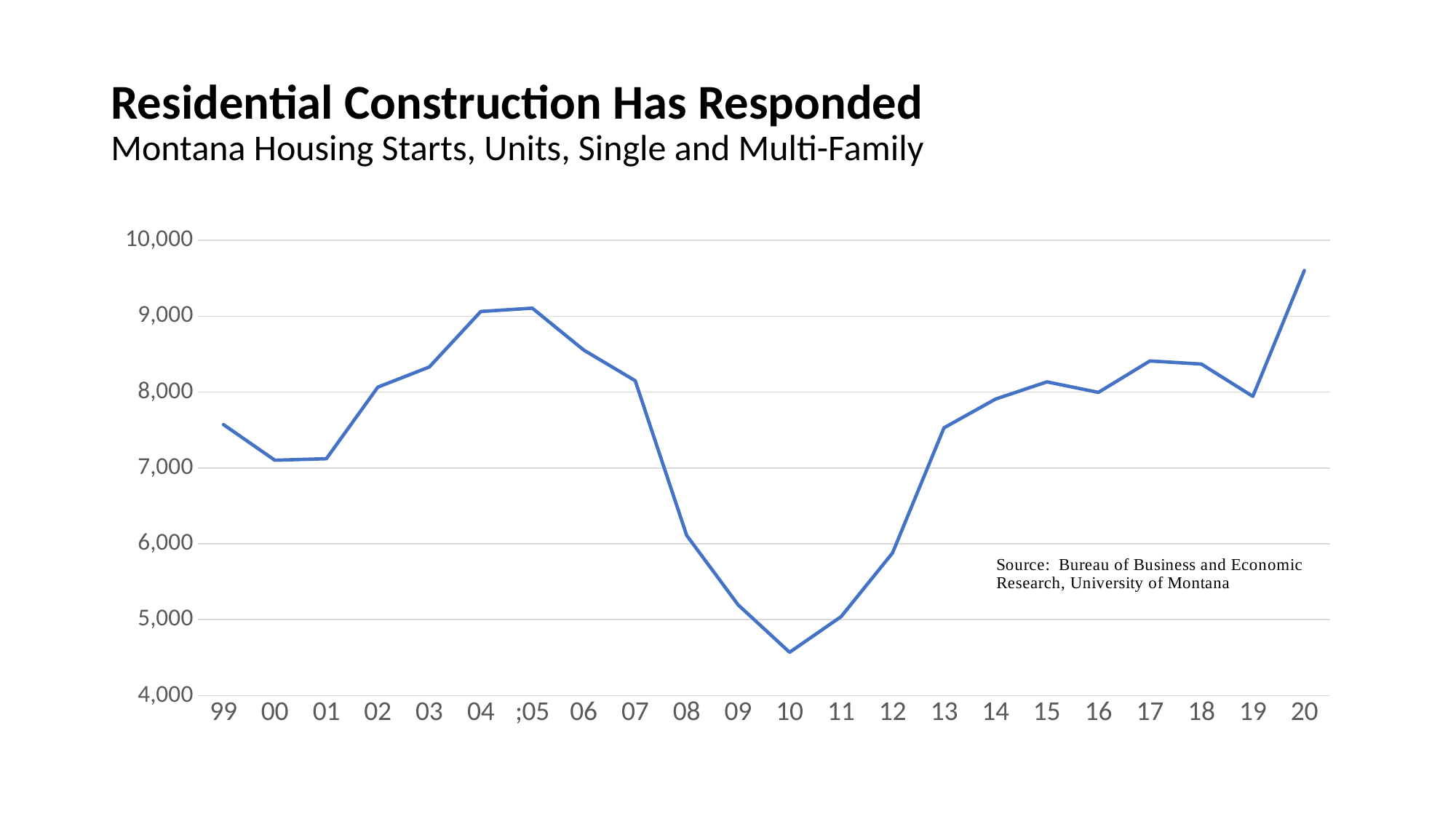
Is the value for 10 greater or less than 5,000? less What kind of chart is shown on the slide? line chart Is the value for 17 greater or less than 8,000? greater Which year has more housing starts, 08 or 09? 08 Which year has more housing starts, 20 or ;05? 20 Which year has the highest number of housing starts? 20 Is the value for 20 greater or less than 9,000? greater Do housing starts rise or fall from 07 to 10? fall What is the source cited on the chart? Bureau of Business and Economic Research, University of Montana Which year has the lowest number of housing starts? 10 How many years are plotted along the x axis? 22